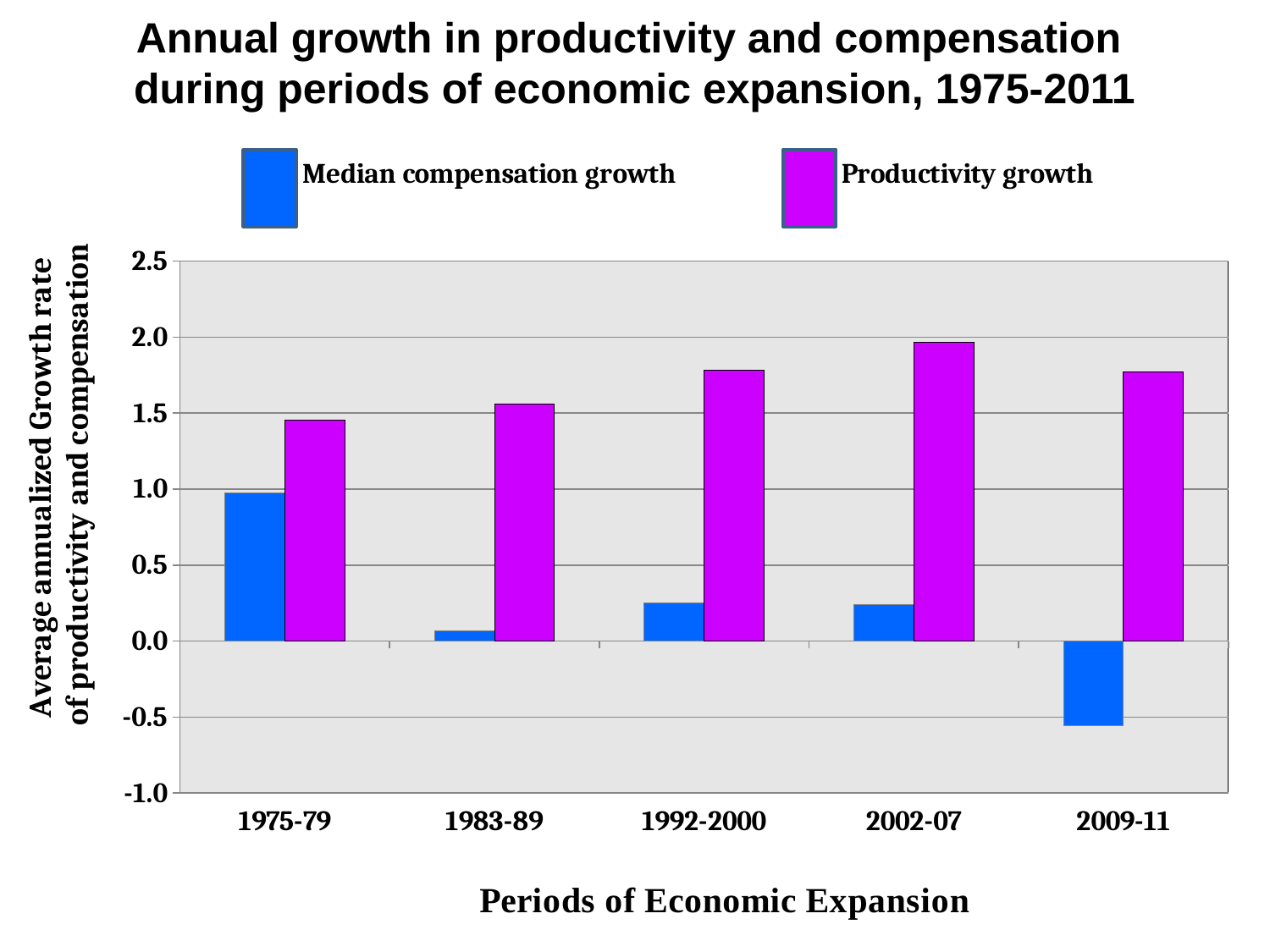
How many series does the legend list? 2 What kind of chart is shown on the slide? bar chart How many periods of economic expansion are shown on the x axis? 5 Is the value for Median compensation growth in 2009-11 greater or less than 0? less In which period is Median compensation growth highest? 1975-79 Which colour represents Productivity growth in the legend? purple In 1975-79, which is larger: Median compensation growth or Productivity growth? Productivity growth In which period is Productivity growth lowest? 1975-79 In which period is Median compensation growth lowest? 2009-11 In which period is Productivity growth highest? 2002-07 Is the value for Productivity growth in 2002-07 greater or less than 1.5? greater Is the value for Median compensation growth in 1983-89 greater or less than 0.5? less